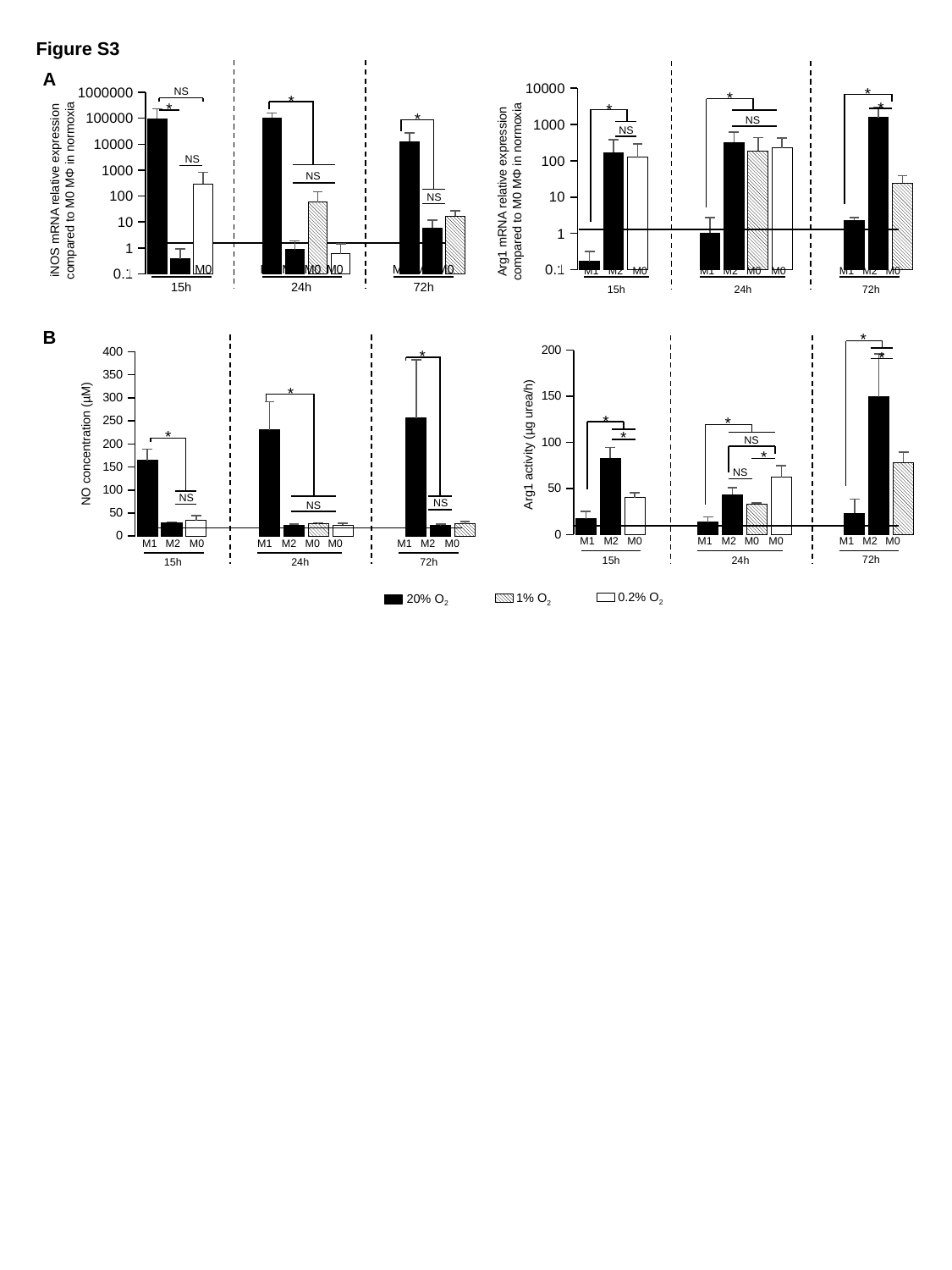
What kind of chart is the NO concentration chart in panel B? bar chart How many time points are shown along the x axis of the Arg1 activity chart (panel B, right)? 3 In the NO concentration chart (panel B, left), which is larger: M1 at 24h or M1 at 15h? M1 at 24h In the Arg1 activity chart (panel B, right), which bar is the highest? M2 at 72h How many series does the legend at the bottom of the slide list? 3 In the Arg1 activity chart (panel B, right), is the value for M2 at 72h greater or less than 100? greater In the Arg1 mRNA relative expression chart (panel A, right), is the value for M2 at 72h greater or less than 1000? greater In the NO concentration chart (panel B, left), is the value for M1 at 15h greater or less than 150? greater In the NO concentration chart (panel B, left), which bar is the highest? M1 at 72h In the Arg1 activity chart (panel B, right), which is larger: M2 at 15h or M2 at 24h? M2 at 15h